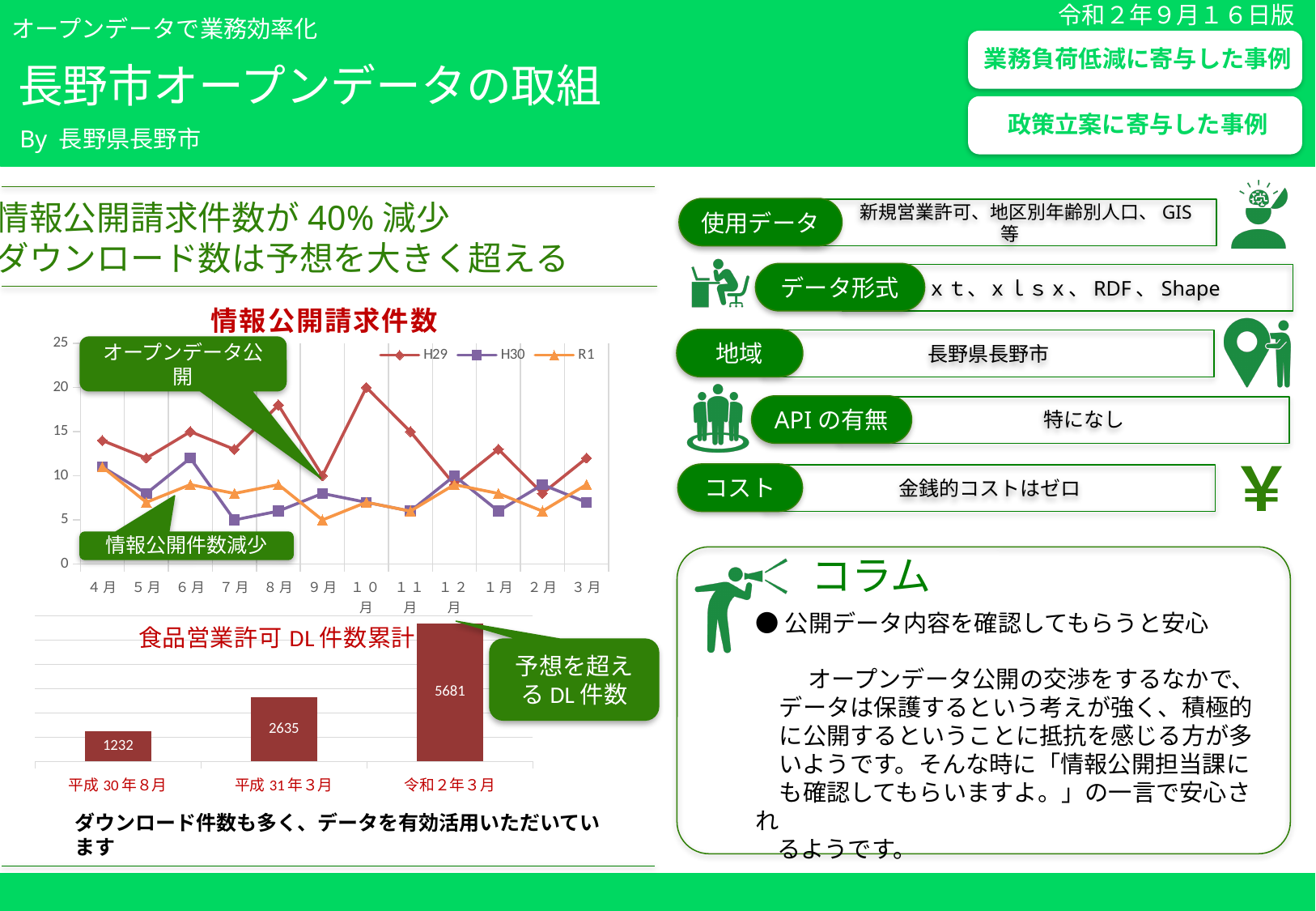
In the 食品営業許可 DL 件数累計 chart, what is the value for 平成 30 年８月? 1232 In the 食品営業許可 DL 件数累計 chart, what is the difference between 令和２年３月 and 平成 31 年３月? 3046 How many months are shown on the x axis of the 情報公開請求件数 chart? 12 In the 食品営業許可 DL 件数累計 chart, do the values rise or fall from left to right? rise In the 食品営業許可 DL 件数累計 chart, which category has the lowest value? 平成 30 年８月 How many series does the legend of the 情報公開請求件数 chart list? 3 In the 情報公開請求件数 chart, is the H29 value for 10月 greater or less than 15? greater What kind of chart is the 食品営業許可 DL 件数累計 chart? bar chart In the 情報公開請求件数 chart, which series has the highest value in 10月? H29 What kind of chart is the 情報公開請求件数 chart? line chart In the 食品営業許可 DL 件数累計 chart, what is the value for 令和２年３月? 5681 In the 情報公開請求件数 chart, is the R1 value for 9月 greater or less than 10? less